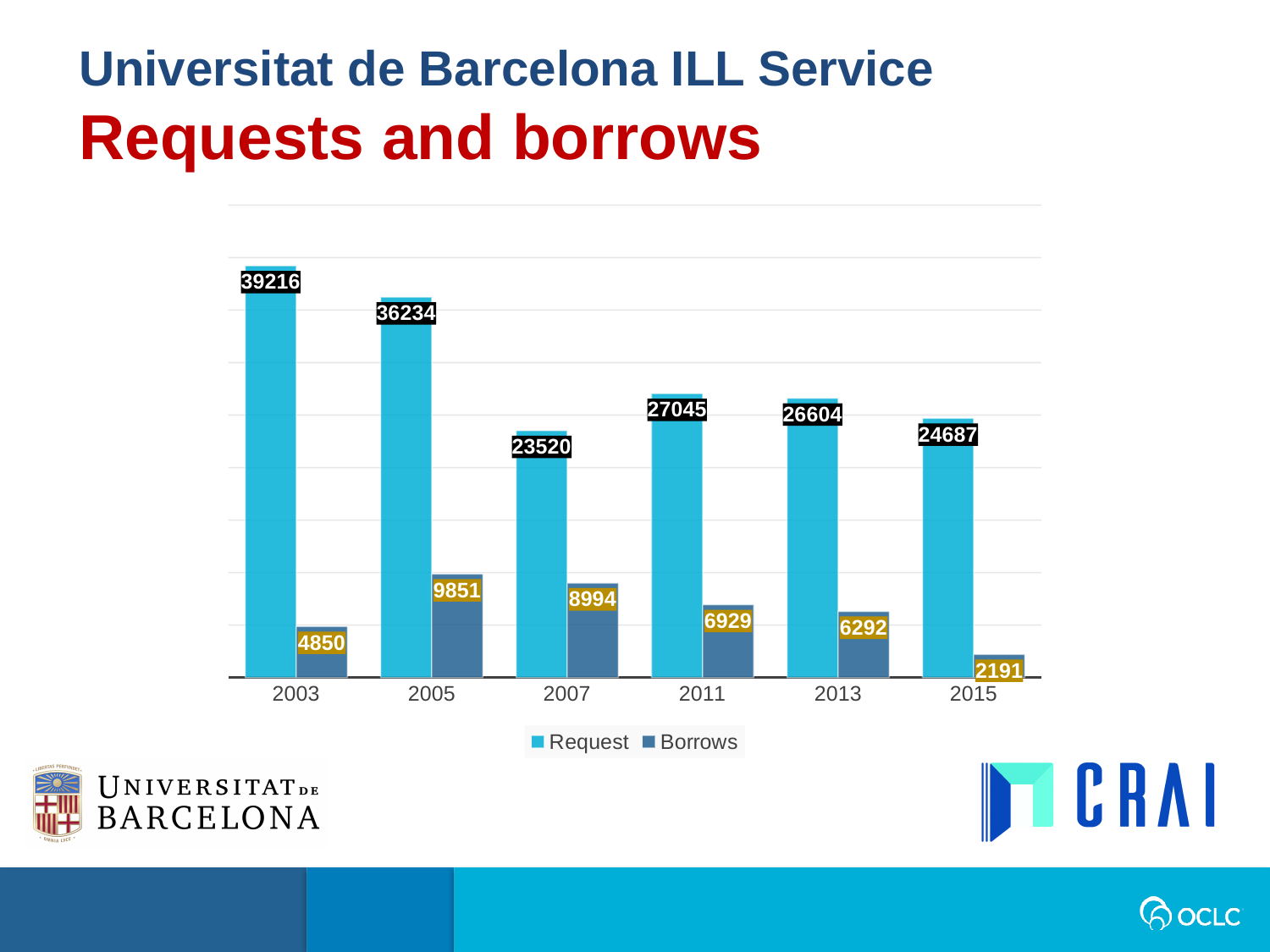
What is the difference between the Request values for 2003 and 2005? 2982 Which is larger, the Request value for 2011 or the Request value for 2013? 2011 Which year has the highest Request value? 2003 How many years are shown on the x axis? 6 Which year has the lowest Borrows value? 2015 What is the Request value for 2003? 39216 Which year has the lowest Request value? 2007 What is the Borrows value for 2005? 9851 What kind of chart is shown on the slide? bar chart What is the Request value for 2015? 24687 What is the difference between the Borrows values for 2007 and 2013? 2702 How many series does the legend list? 2